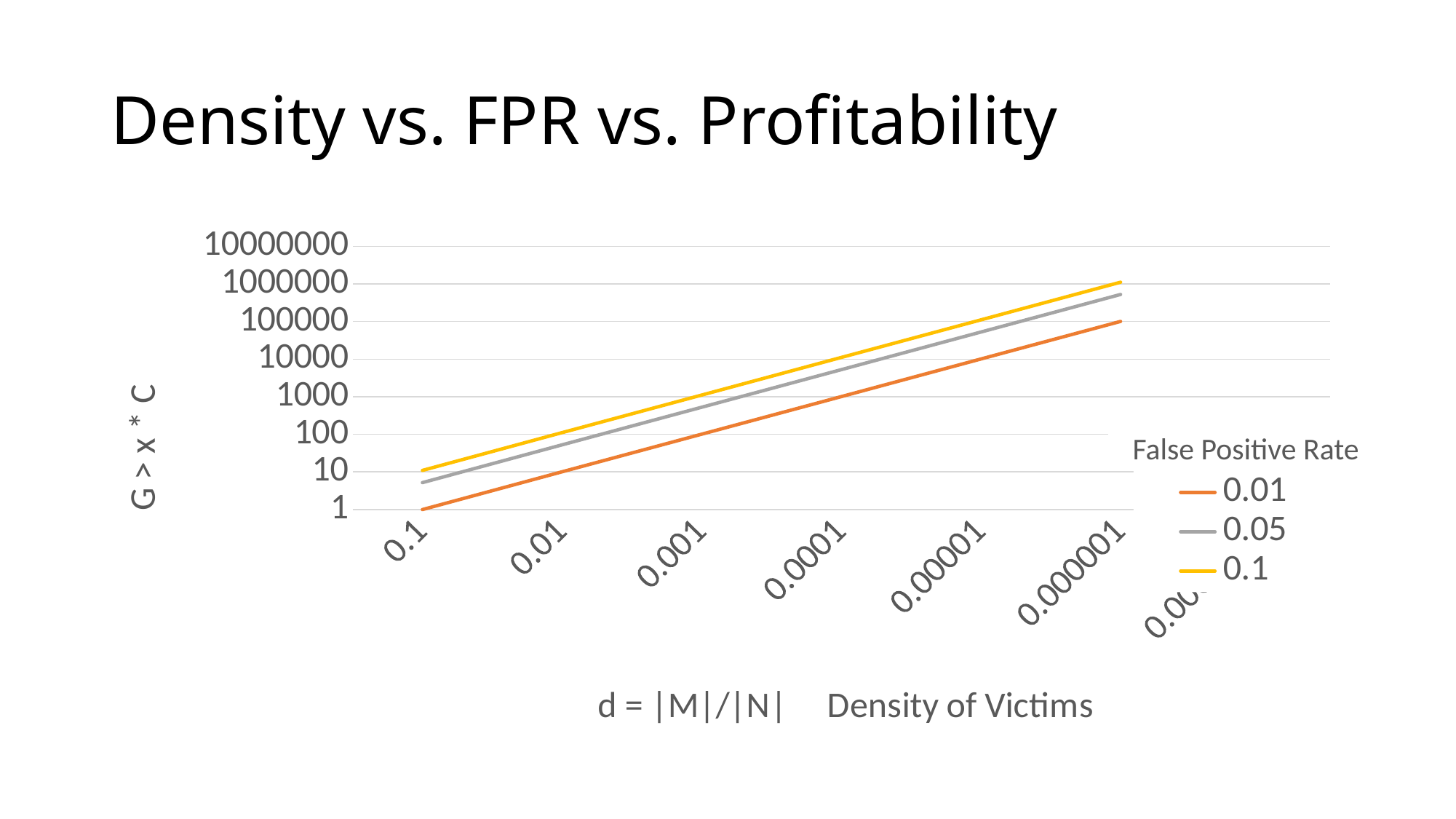
What kind of chart is shown on the slide? line chart What is the title of the chart? Density vs. FPR vs. Profitability Do the values of the series rise or fall as the density moves from 0.1 to 0.000001 along the x axis? rise Is the value for the 0.05 series at a density of 0.1 greater or less than 1? greater Which series has the highest value at a density of 0.000001? 0.1 How many series does the legend list? 3 What is the title of the legend? False Positive Rate What is the value of the 0.01 series at a density of 0.1? 1 Which series has the lowest value at a density of 0.1? 0.01